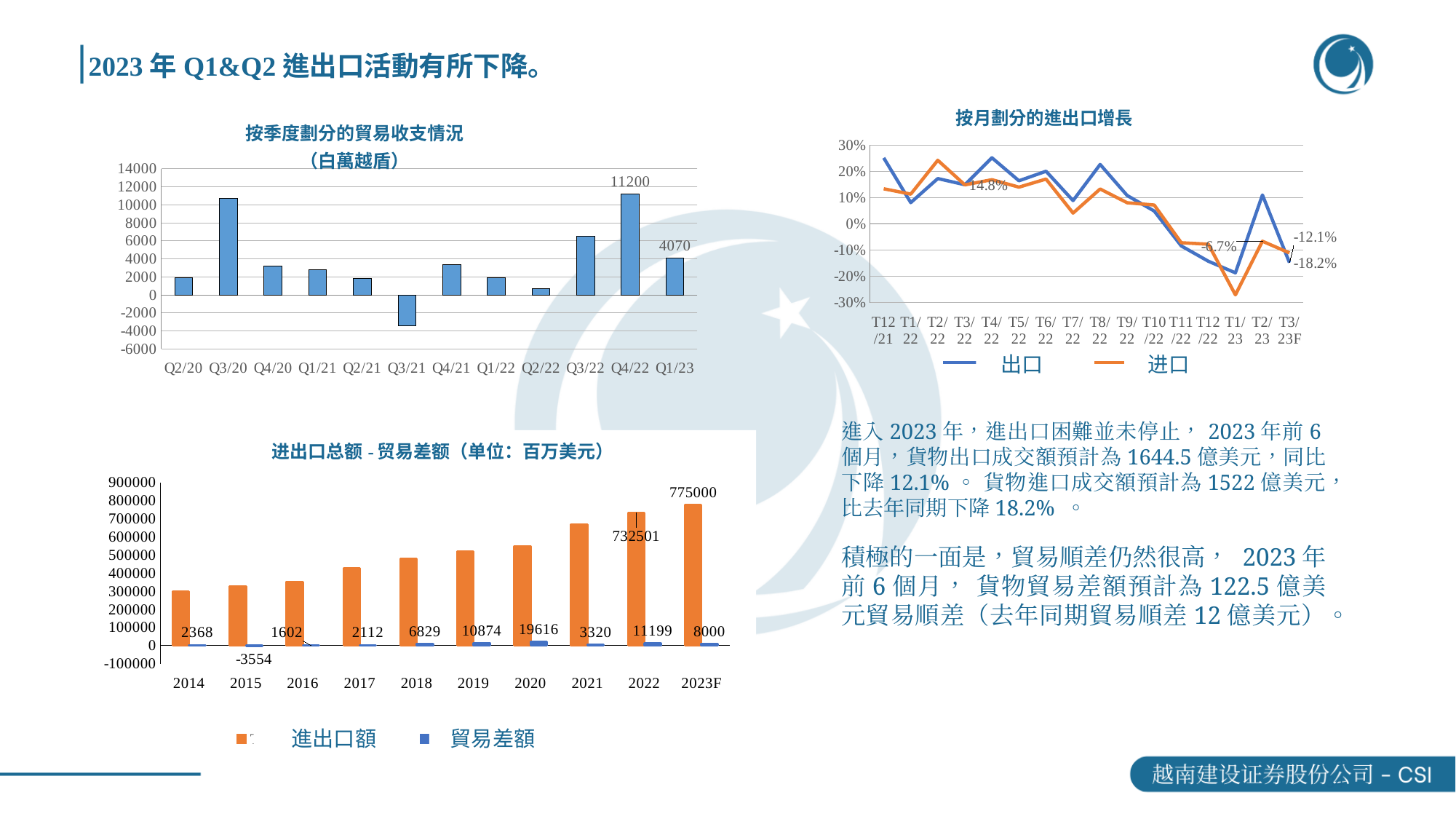
In the chart titled 按季度劃分的貿易收支情況, is the value for Q3/20 greater or less than 10000? greater In the chart titled 按季度劃分的貿易收支情況, what is the value for Q4/22? 11200 In the chart titled 进出口总额 - 贸易差额, what is the difference between the 進出口額 values for 2023F and 2022? 42499 In the chart titled 进出口总额 - 贸易差额, what is the 貿易差額 value for 2020? 19616 In the chart titled 进出口总额 - 贸易差额, which year has the lowest 貿易差額 value? 2015 In the chart titled 按季度劃分的貿易收支情況, what is the value for Q1/23? 4070 In the chart titled 按月劃分的進出口增長, how many series does the legend list? 2 What kind of chart is the one titled 按月劃分的進出口增長? line chart In the chart titled 进出口总额 - 贸易差额, do the 進出口額 values rise or fall from 2014 to 2023F? rise In the chart titled 按季度劃分的貿易收支情況, how many quarters are shown on the x axis? 12 In the chart titled 按季度劃分的貿易收支情況, which quarter has the lowest value? Q3/21